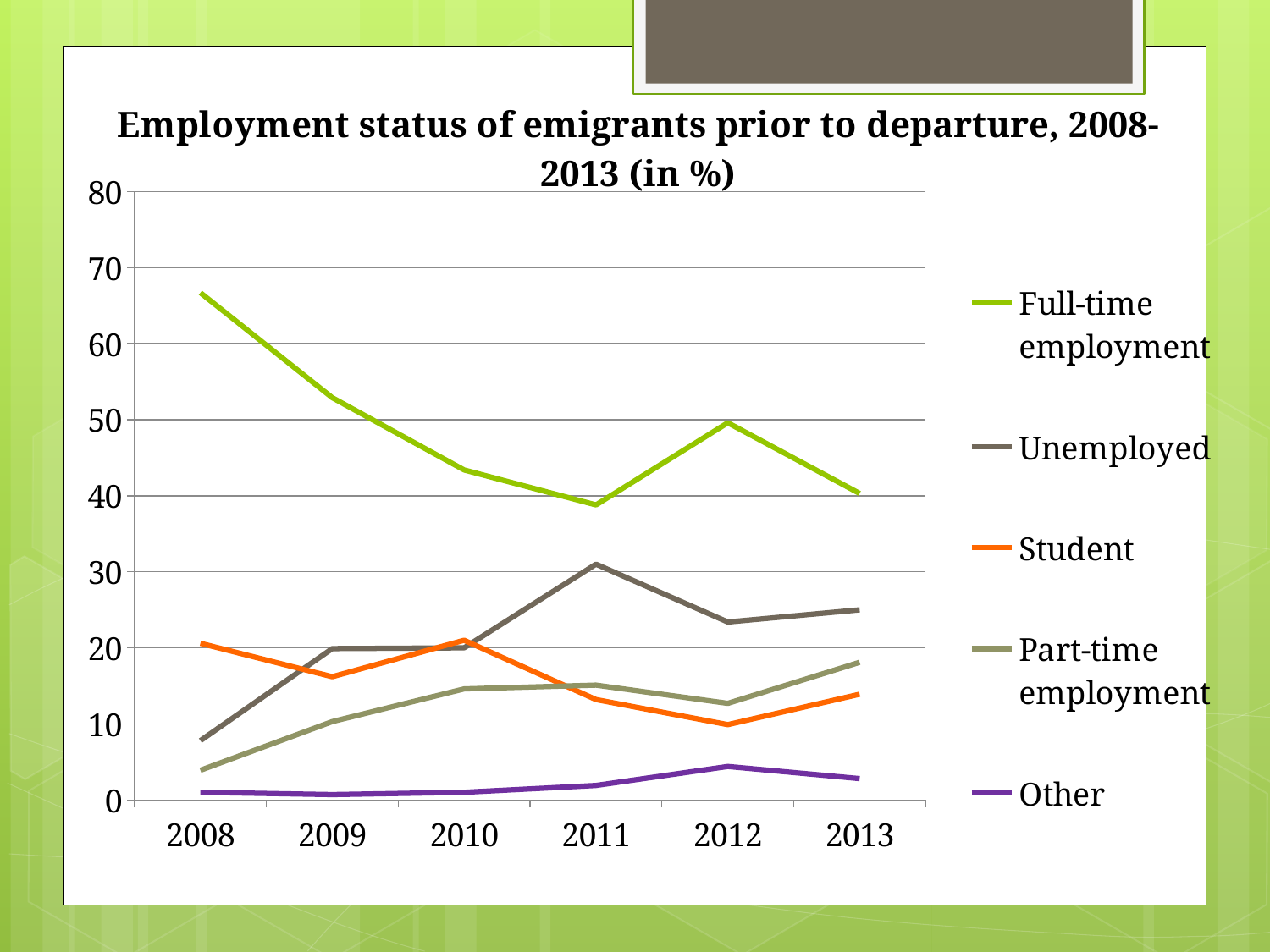
What kind of chart is shown on the slide? line chart In 2013, which is larger: Unemployed or Student? Unemployed Is the value for Full-time employment in 2008 greater or less than 60? greater How many series does the legend list? 5 How many years are shown on the x axis? 6 In which year is Unemployed highest? 2011 Does Full-time employment rise or fall from 2008 to 2011? fall Is the value for Unemployed in 2008 greater or less than 10? less Which series has the lowest values across all years? Other Is the value for Full-time employment in 2012 greater or less than 40? greater In which year is Full-time employment highest? 2008 In 2008, which is larger: Student or Unemployed? Student